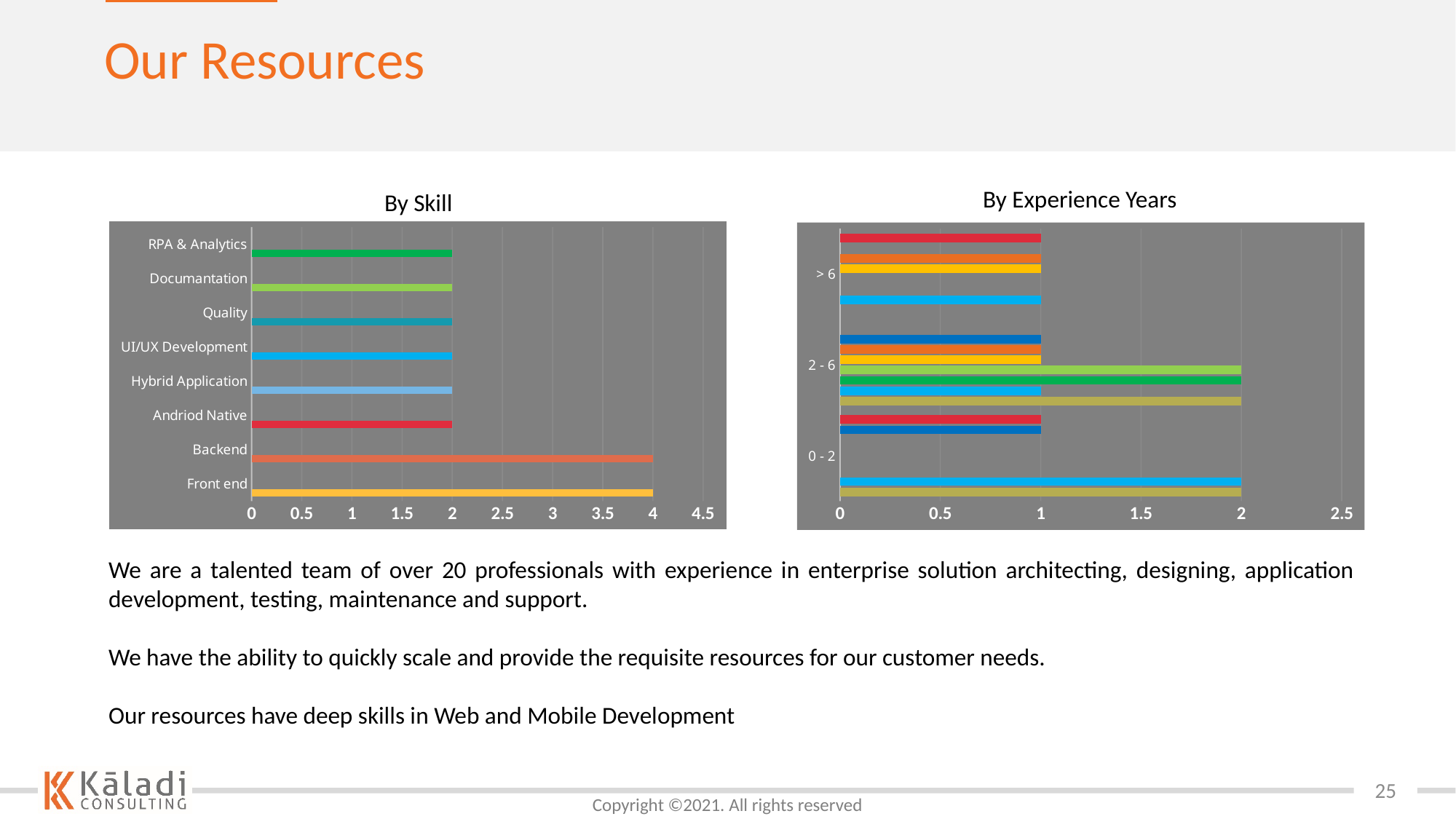
In the "By Skill" chart, what is the value for Backend? 4 How many experience-year categories are shown in the "By Experience Years" chart? 3 What is the title of the chart on the left side of the slide? By Skill In the "By Skill" chart, is the value for Front end greater or less than 3? greater In the "By Skill" chart, what is the value for Quality? 2 What kind of chart is the "By Skill" chart? bar chart How many skill categories are shown in the "By Skill" chart? 8 In the "By Skill" chart, what is the difference between the values for Backend and Andriod Native? 2 In the "By Skill" chart, what is the value for Hybrid Application? 2 In the "By Skill" chart, is the value for UI/UX Development greater or less than 3? less In the "By Skill" chart, which is larger, Backend or Quality? Backend In the "By Skill" chart, what is the value for Front end? 4